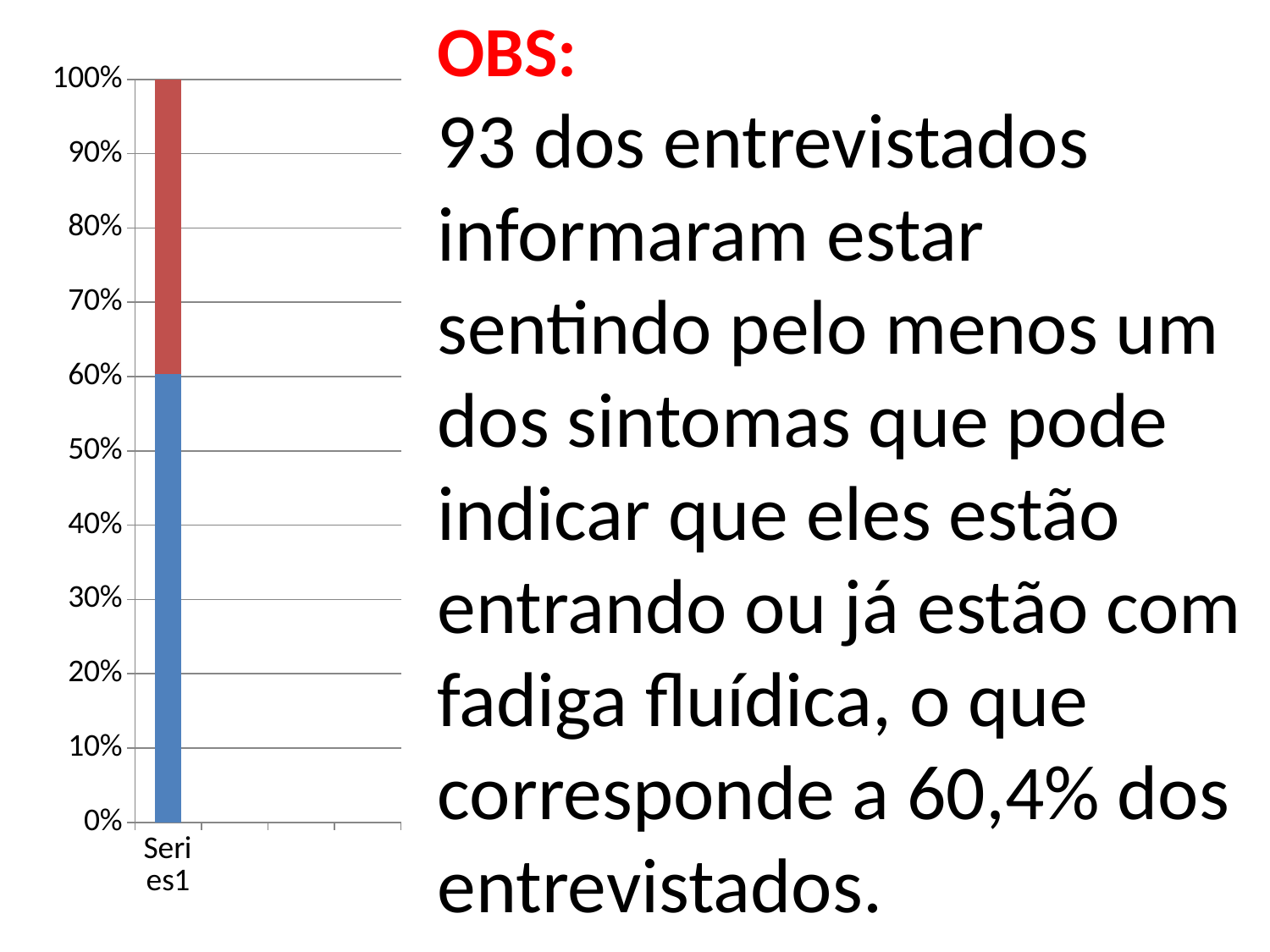
What is the highest value shown on the y axis? 100% Is the red segment of the bar greater or less than 50%? less What is the total height of the stacked bar, as read from the y axis? 100% Is the blue segment of the bar greater or less than 50%? greater What is the label of the single category on the x axis? Series1 What is the interval between consecutive tick marks on the y axis? 10% How many categories are plotted on the x axis of the chart? 1 What kind of chart is shown on the slide? Stacked bar chart Which segment of the stacked bar is larger, the blue one or the red one? The blue one Is the red segment of the bar greater or less than 30%? greater